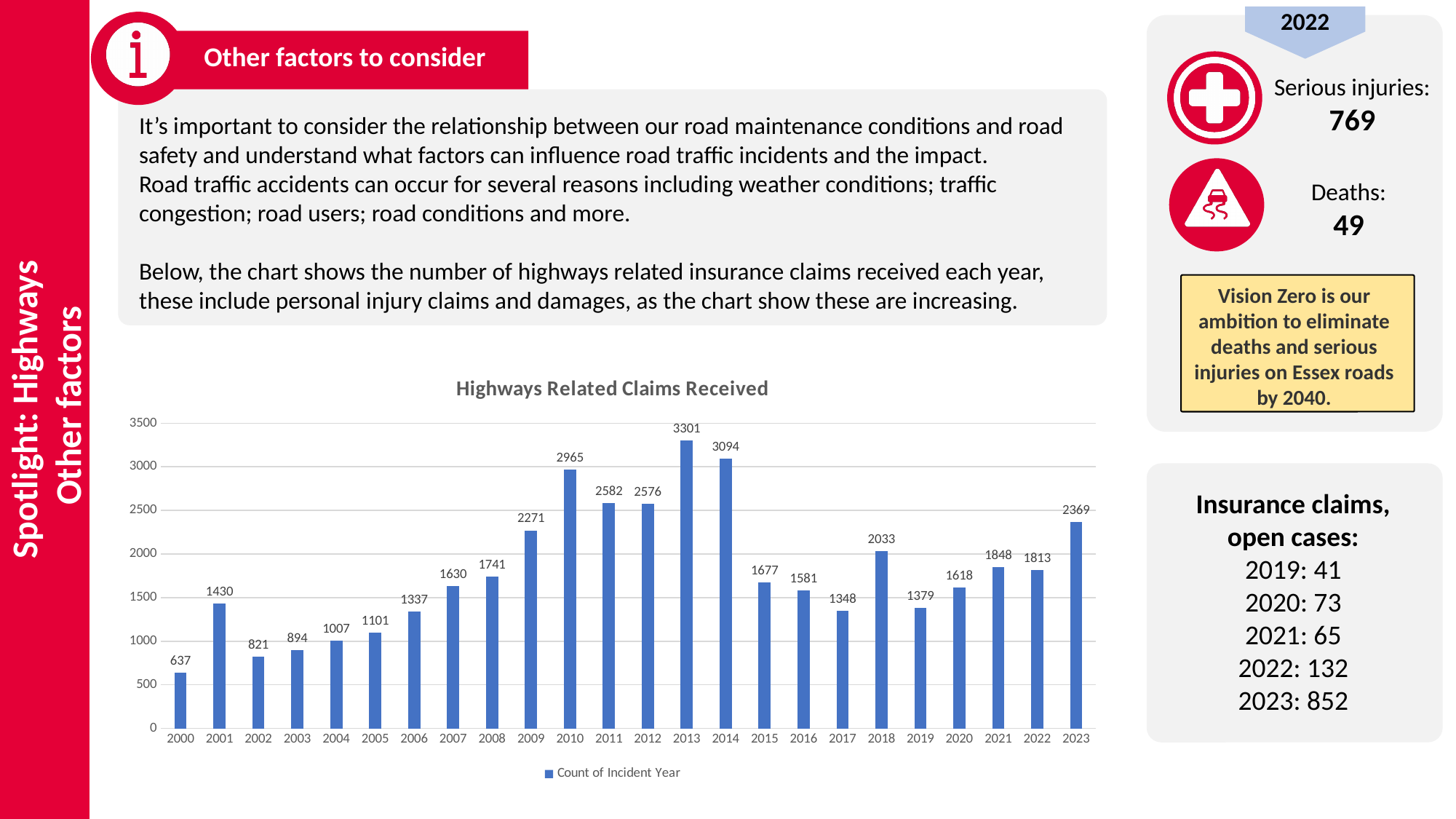
Is the value for 2018 greater or less than 2000? greater How many years are shown on the x axis of the chart? 24 Which year has the lowest number of highways related claims received? 2000 Which year has the highest number of highways related claims received? 2013 What is the legend entry shown below the chart? Count of Incident Year What is the value shown for 2023 in the chart? 2369 Which year had more claims received, 2010 or 2011? 2010 What is the value for 2013 in the Highways Related Claims Received chart? 3301 How many claims were received in 2000 according to the chart? 637 What is the difference between the claims received in 2013 and 2014? 207 How many series does the chart legend list? 1 What kind of chart is used to show Highways Related Claims Received? Bar chart